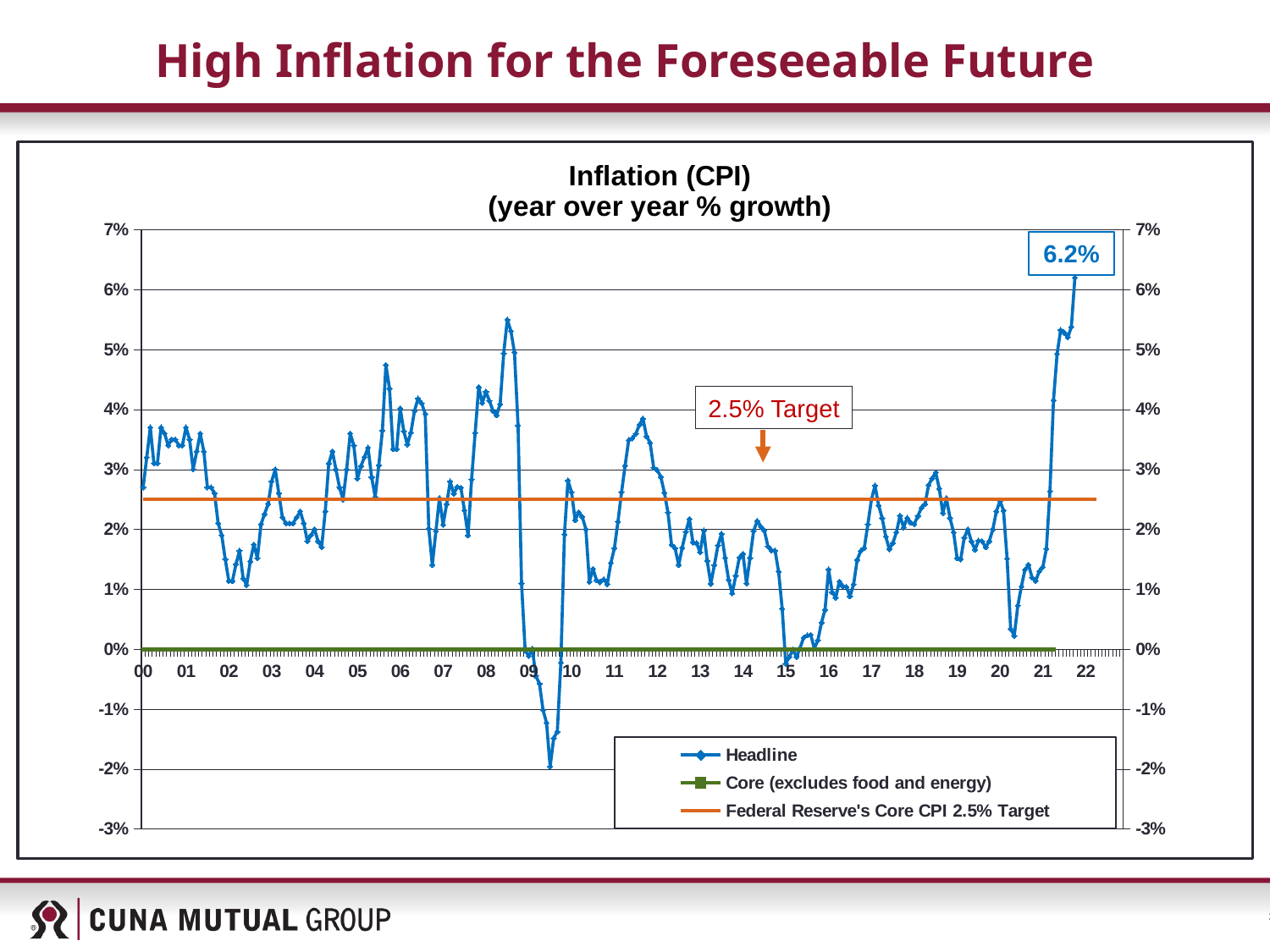
In which year does the Headline series reach its lowest point? 09 What is the title of the chart? Inflation (CPI) (year over year % growth) What is the latest Headline inflation value labeled on the chart? 6.2% Which is larger, the latest Headline value or the Federal Reserve's 2.5% target? Headline By how many percentage points does the latest Headline value of 6.2% exceed the 2.5% target? 3.7 Is the Headline peak in 2008 greater or less than 5%? greater Is the lowest Headline value in 2009 greater or less than -1%? less What is the highest value reached by the Headline series? 6.2% What is the Federal Reserve's Core CPI target shown on the chart? 2.5% What kind of chart is shown on the slide? line chart How many series does the legend list? 3 What is the legend label for the green series? Core (excludes food and energy)